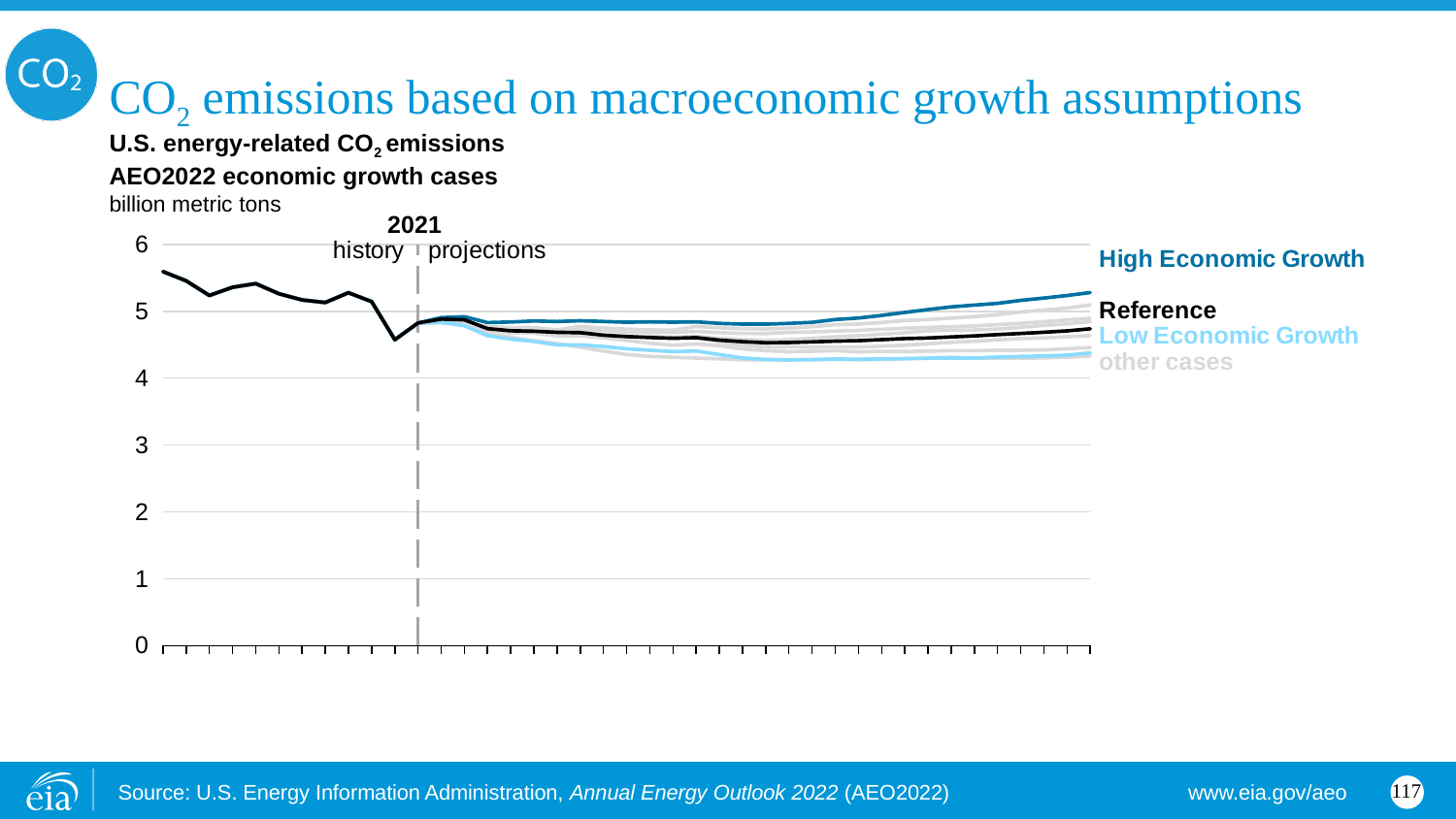
At the end of the projection period, is the value for the Reference case greater or less than 5? less Which case has higher emissions at the end of the projection period, High Economic Growth or Low Economic Growth? High Economic Growth What kind of chart is shown on the slide? line chart At the start of the history period, is the emissions value greater or less than 5? greater Which case has the highest emissions at the end of the projection period? High Economic Growth At the end of the projection period, is the value for the High Economic Growth case greater or less than 5? greater Which named case has the lowest emissions at the end of the projection period? Low Economic Growth What is the title of the chart? U.S. energy-related CO2 emissions, AEO2022 economic growth cases Over the history period up to 2021, do emissions generally rise or fall? fall In what unit are the emissions on the chart measured? billion metric tons